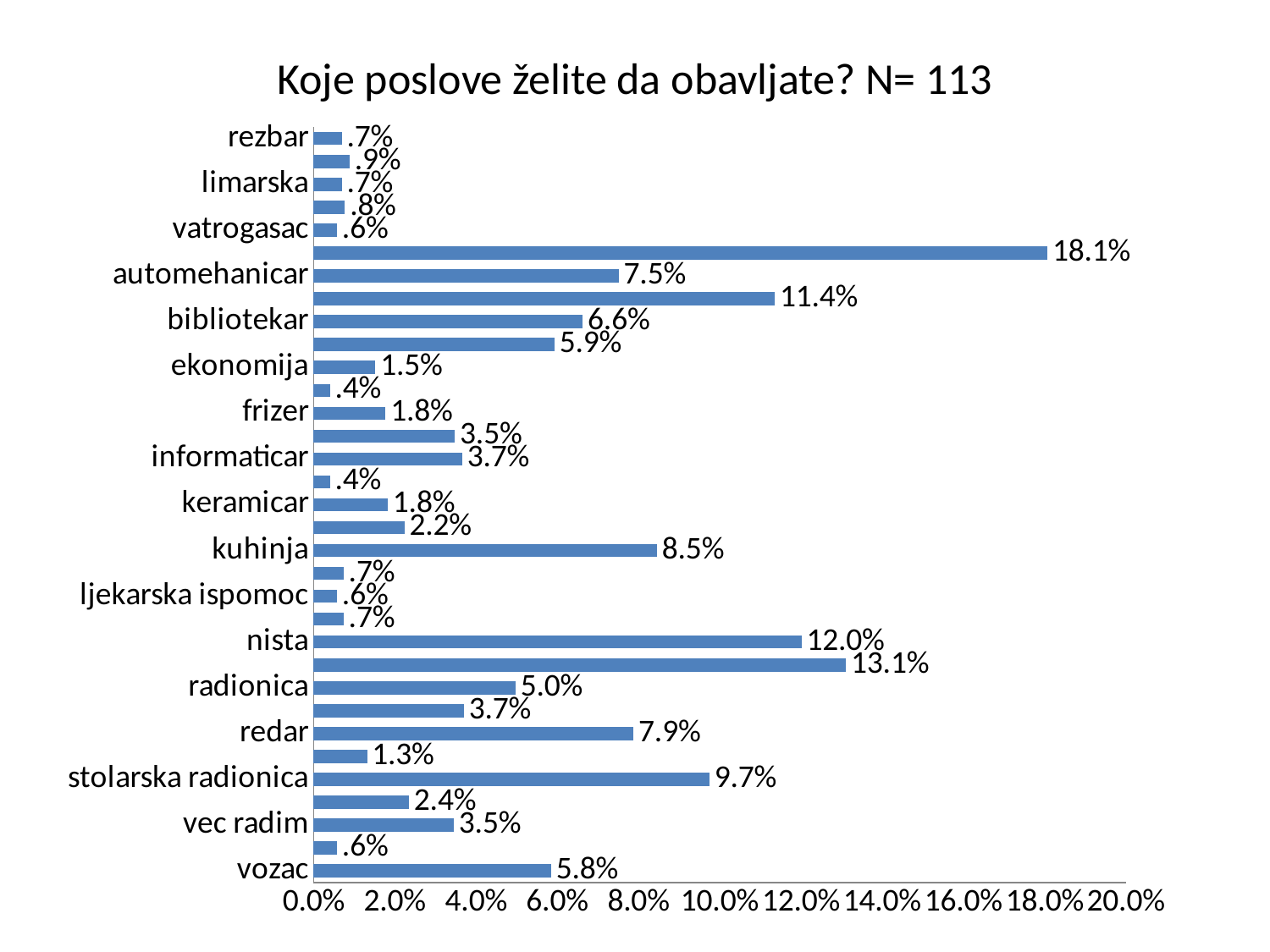
Which is larger, the value for redar or the value for bibliotekar? redar What is the difference between the values for radionica and vec radim? 1.5% What is the value for kuhinja? 8.5% What is the largest value shown on the chart? 18.1% What is the difference between the values for nista and kuhinja? 3.5% What kind of chart is shown on the slide? bar chart What is the value for vozac? 5.8% Is the value for stolarska radionica greater or less than 8.0%? greater What is the title of the chart? Koje poslove želite da obavljate? N= 113 What is the value for stolarska radionica? 9.7% What is the value for automehanicar? 7.5% What is the value for nista? 12.0%